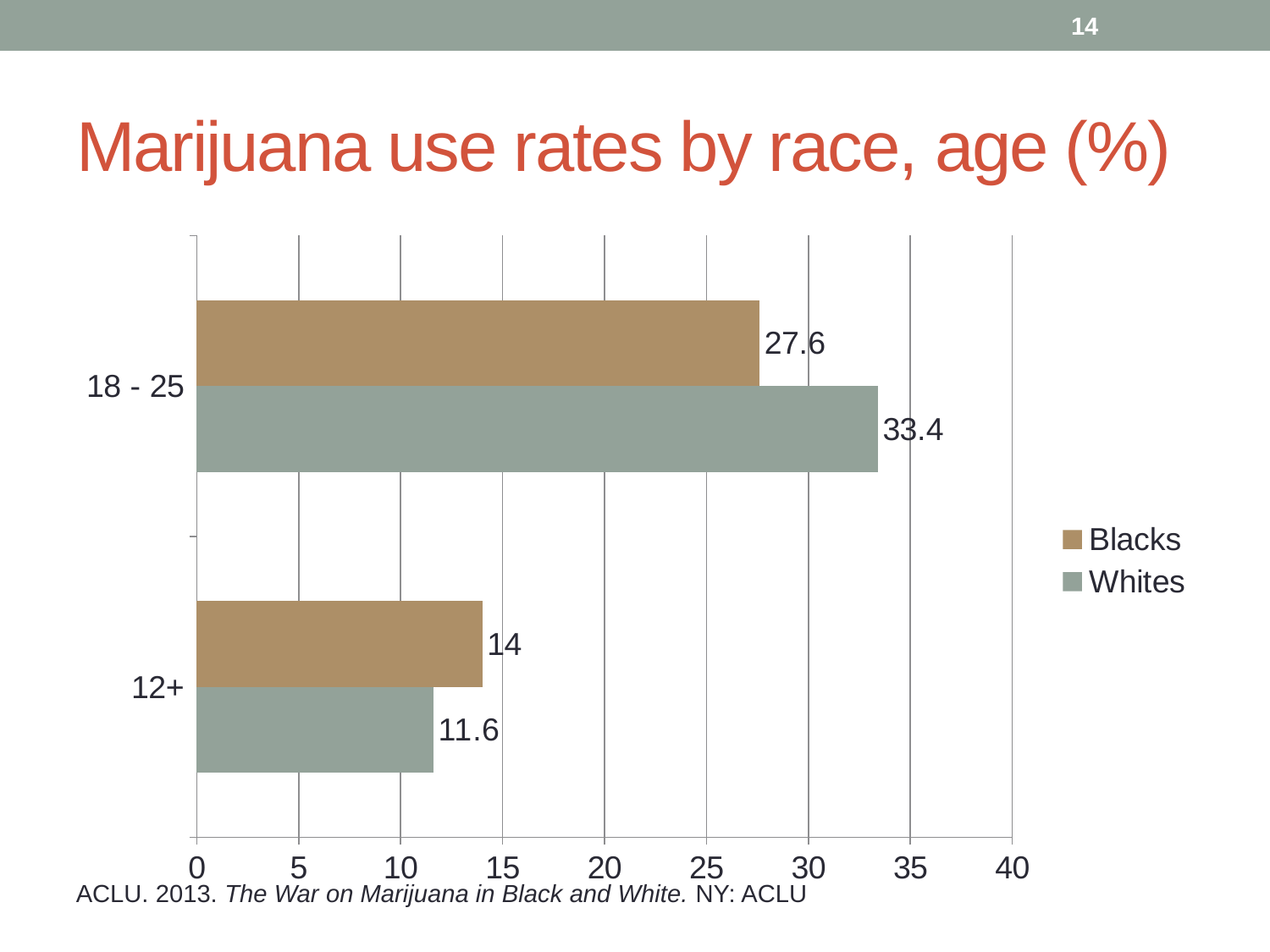
Which group and age category has the highest marijuana use rate on the chart? Whites, 18 - 25 What is the marijuana use rate for Whites aged 18 - 25? 33.4 How many age categories are shown on the chart? 2 What is the marijuana use rate for Blacks aged 18 - 25? 27.6 What is the difference between the use rates for Blacks and Whites aged 12+? 2.4 How many series does the legend list? 2 In the 12+ age group, which has the higher use rate, Blacks or Whites? Blacks What is the difference between the use rates for Whites and Blacks aged 18 - 25? 5.8 Which group and age category has the lowest marijuana use rate on the chart? Whites, 12+ What kind of chart is shown on the slide? Bar chart What is the marijuana use rate for Whites aged 12+? 11.6 What is the marijuana use rate for Blacks aged 12+? 14